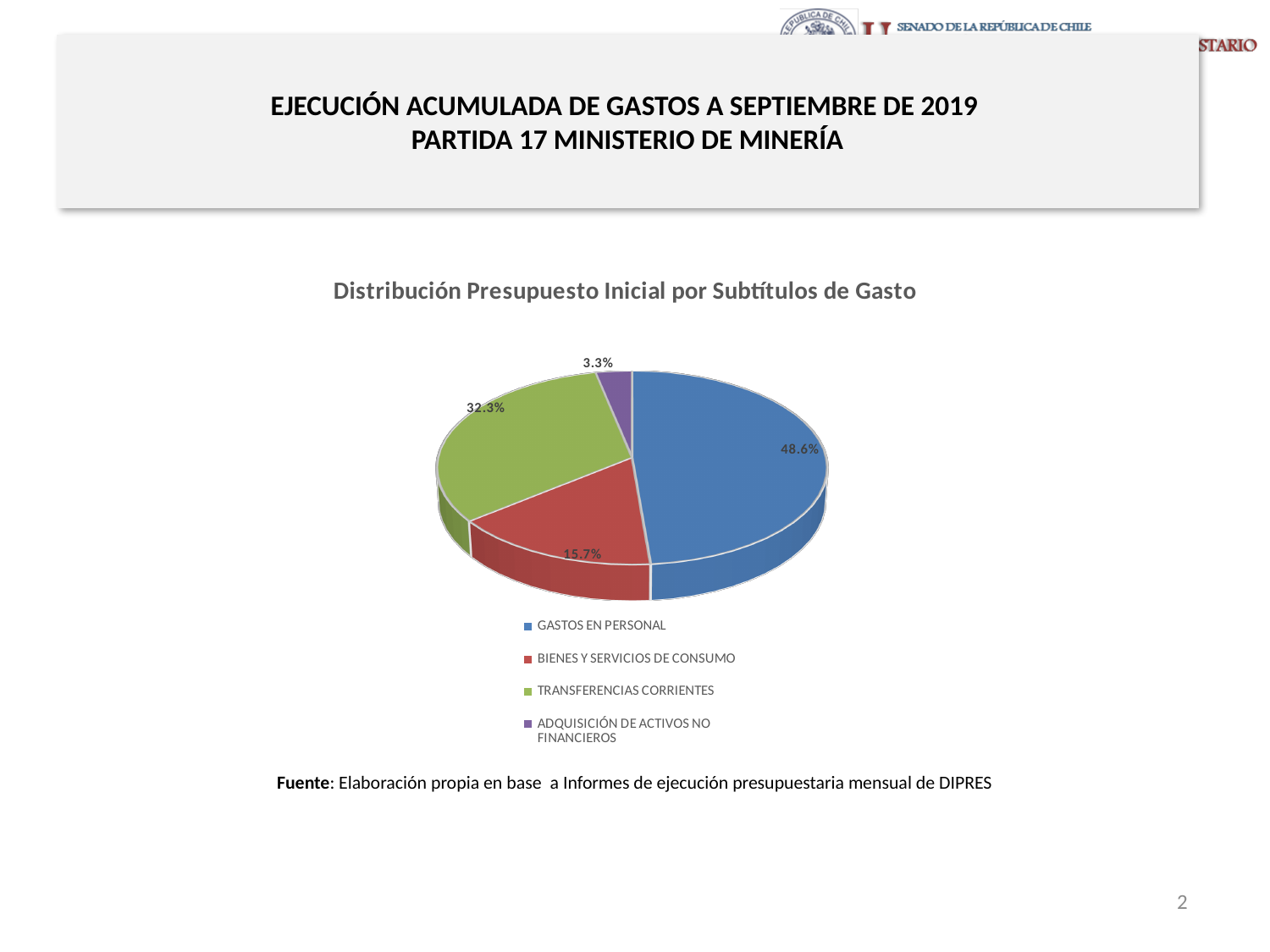
What share of the pie does TRANSFERENCIAS CORRIENTES represent? 32.3% What kind of chart is shown on the slide? Pie chart Which is larger, the share for BIENES Y SERVICIOS DE CONSUMO or the share for TRANSFERENCIAS CORRIENTES? TRANSFERENCIAS CORRIENTES What share of the pie does ADQUISICIÓN DE ACTIVOS NO FINANCIEROS represent? 3.3% How many categories does the pie chart show? 4 What colour is the slice for TRANSFERENCIAS CORRIENTES? Green Which category has the largest share of the pie? GASTOS EN PERSONAL What is the difference in percentage points between GASTOS EN PERSONAL and TRANSFERENCIAS CORRIENTES? 16.3 What is the title of the chart? Distribución Presupuesto Inicial por Subtítulos de Gasto Which category has the smallest share of the pie? ADQUISICIÓN DE ACTIVOS NO FINANCIEROS What share of the pie does GASTOS EN PERSONAL represent? 48.6%